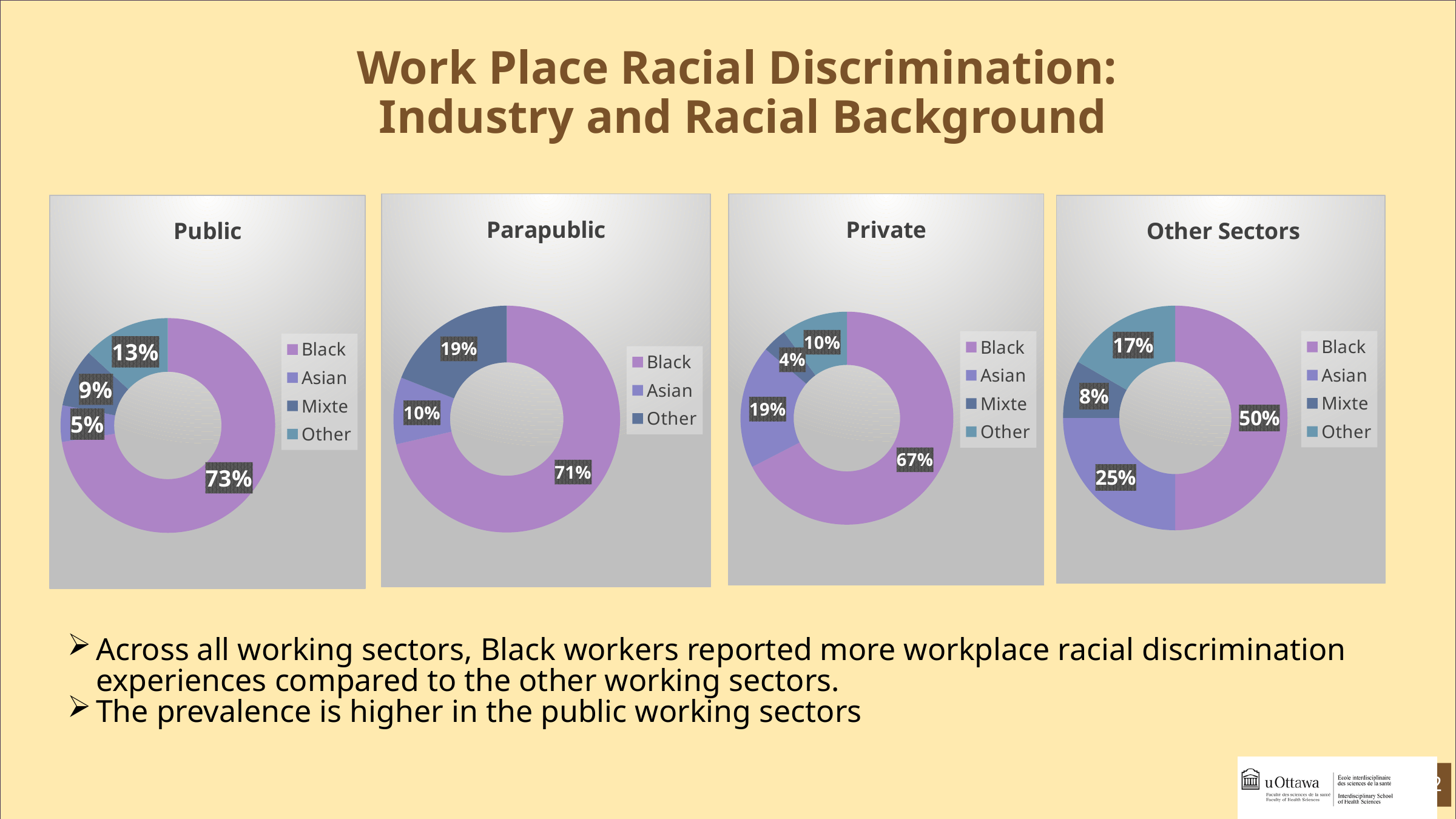
In the Public chart, which category has the smallest share? Asian In the Parapublic chart, what percentage is shown for Other? 19% In the Public chart, what percentage is shown for Black? 73% In the Private chart, what is the difference between the Black and Other shares? 57% What kind of chart is used for the Private sector? Doughnut chart How many series does the legend of the Parapublic chart list? 3 In the Public chart, which is larger, the share for Mixte or the share for Other? Other In the Other Sectors chart, what is the difference between the Black and Asian shares? 25% In the Private chart, what percentage is shown for Asian? 19% In the Private chart, which category has the largest share? Black In the Other Sectors chart, what percentage is shown for Mixte? 8% How many charts are shown on the slide? 4